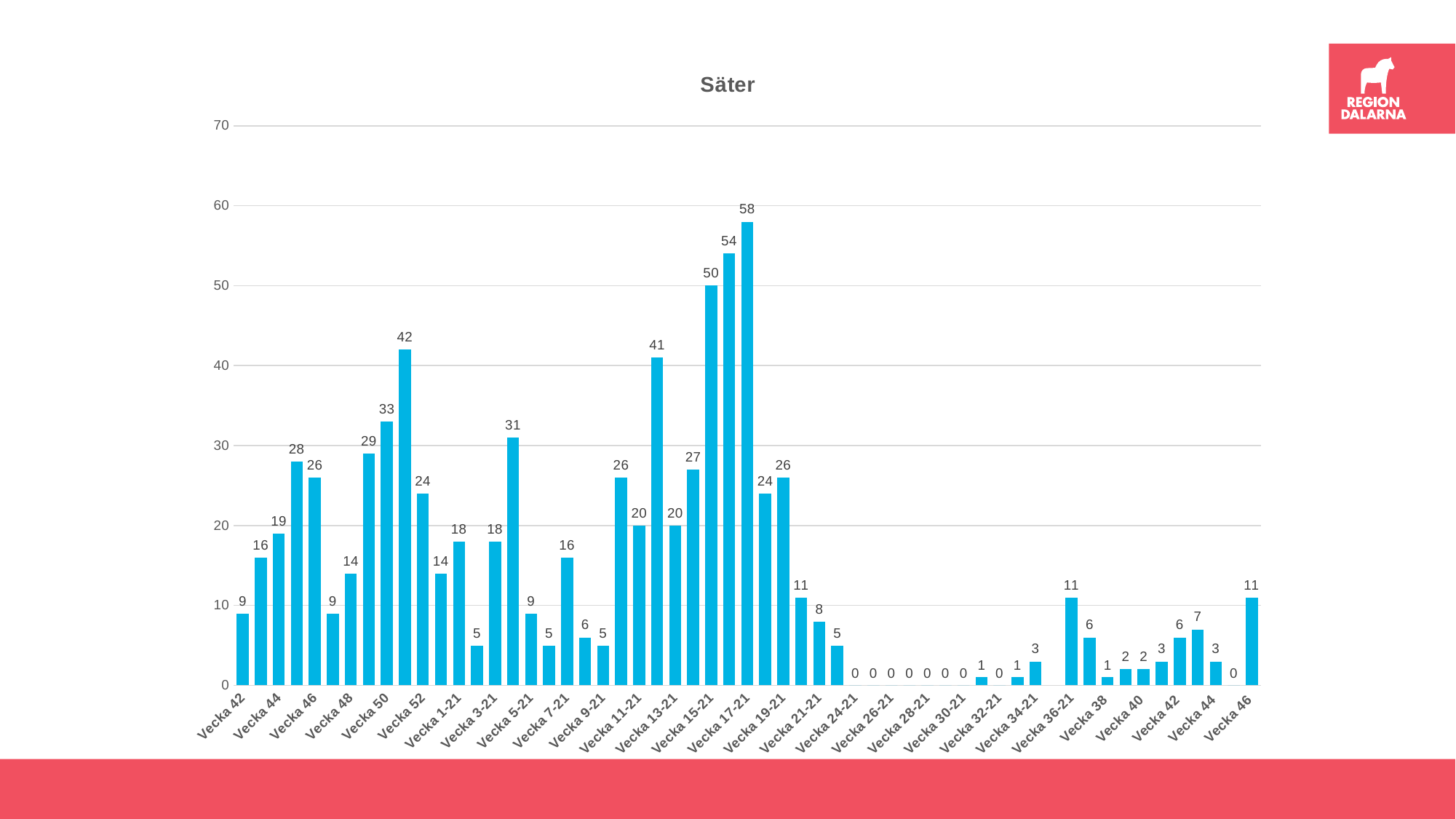
What is the value for the rightmost bar, Vecka 46? 11 Is the value for Vecka 11-21 greater or less than 30? less What is the value for Vecka 52? 24 What is the highest value shown in the chart? 58 Which is larger, the value for Vecka 50 or the value for Vecka 52? Vecka 50 Which week has the highest value in the chart? Vecka 17-21 What is the value for Vecka 1-21? 18 What is the title of the chart? Säter What is the difference between the values for Vecka 17-21 and Vecka 15-21? 8 What kind of chart is shown on the slide? bar chart What is the value for Vecka 50? 33 What is the value for Vecka 15-21? 50